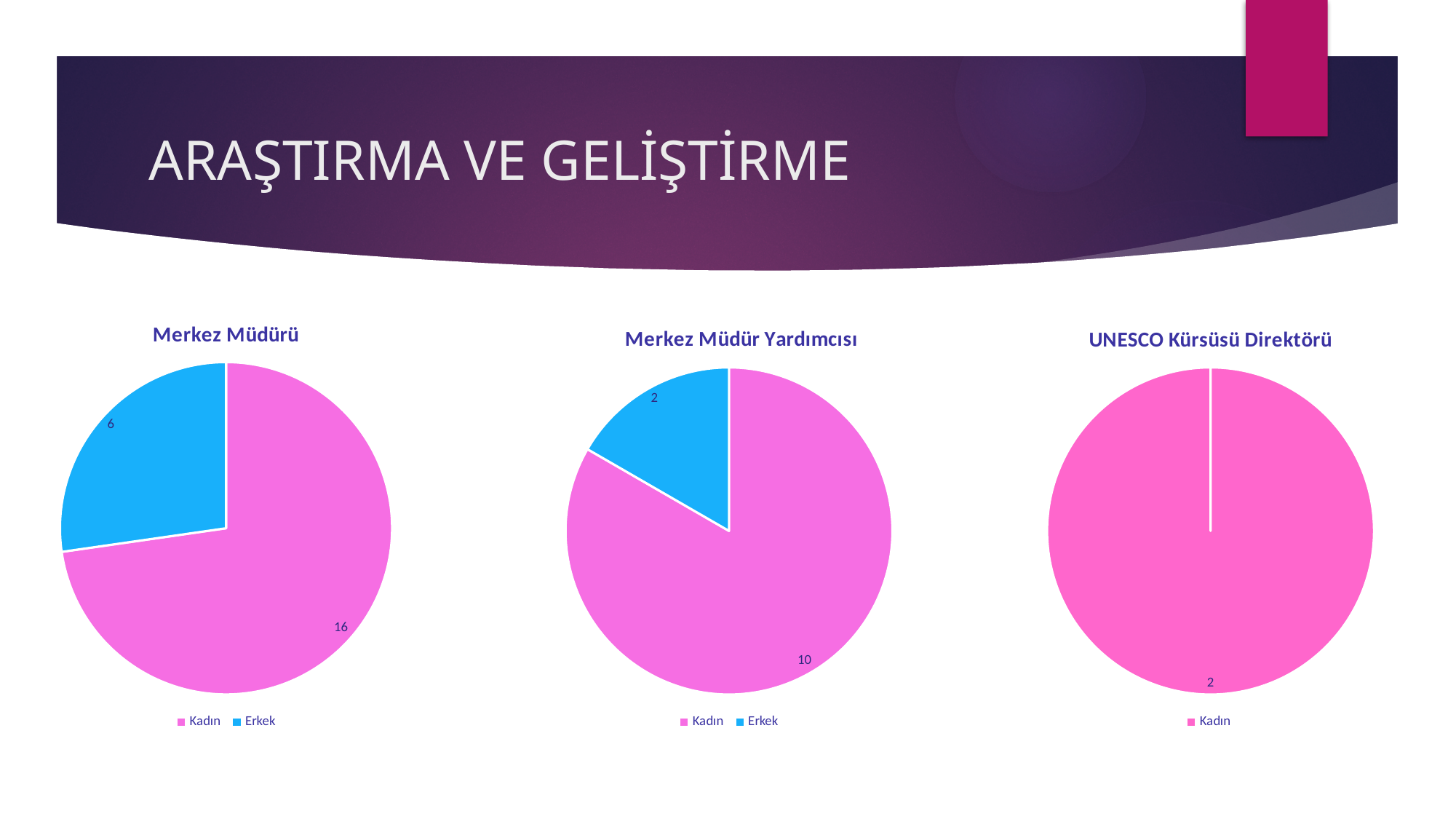
What kind of chart is the 'Merkez Müdürü' chart? Pie chart How many entries does the legend of the 'UNESCO Kürsüsü Direktörü' chart list? 1 In the 'UNESCO Kürsüsü Direktörü' chart, what is the value for Kadın? 2 In the 'UNESCO Kürsüsü Direktörü' chart, what share of the pie does Kadın represent? 100% In the 'Merkez Müdür Yardımcısı' chart, what is the value for Erkek? 2 In the 'Merkez Müdür Yardımcısı' chart, which category is smallest? Erkek In the 'Merkez Müdürü' chart, which category is largest? Kadın In the 'Merkez Müdürü' chart, what is the difference between the Kadın and Erkek values? 10 In the 'Merkez Müdürü' chart, what is the value for Kadın? 16 In the 'Merkez Müdür Yardımcısı' chart, what is the value for Kadın? 10 In the 'Merkez Müdür Yardımcısı' chart, what is the difference between the Kadın and Erkek values? 8 In the 'Merkez Müdürü' chart, what is the value for Erkek? 6